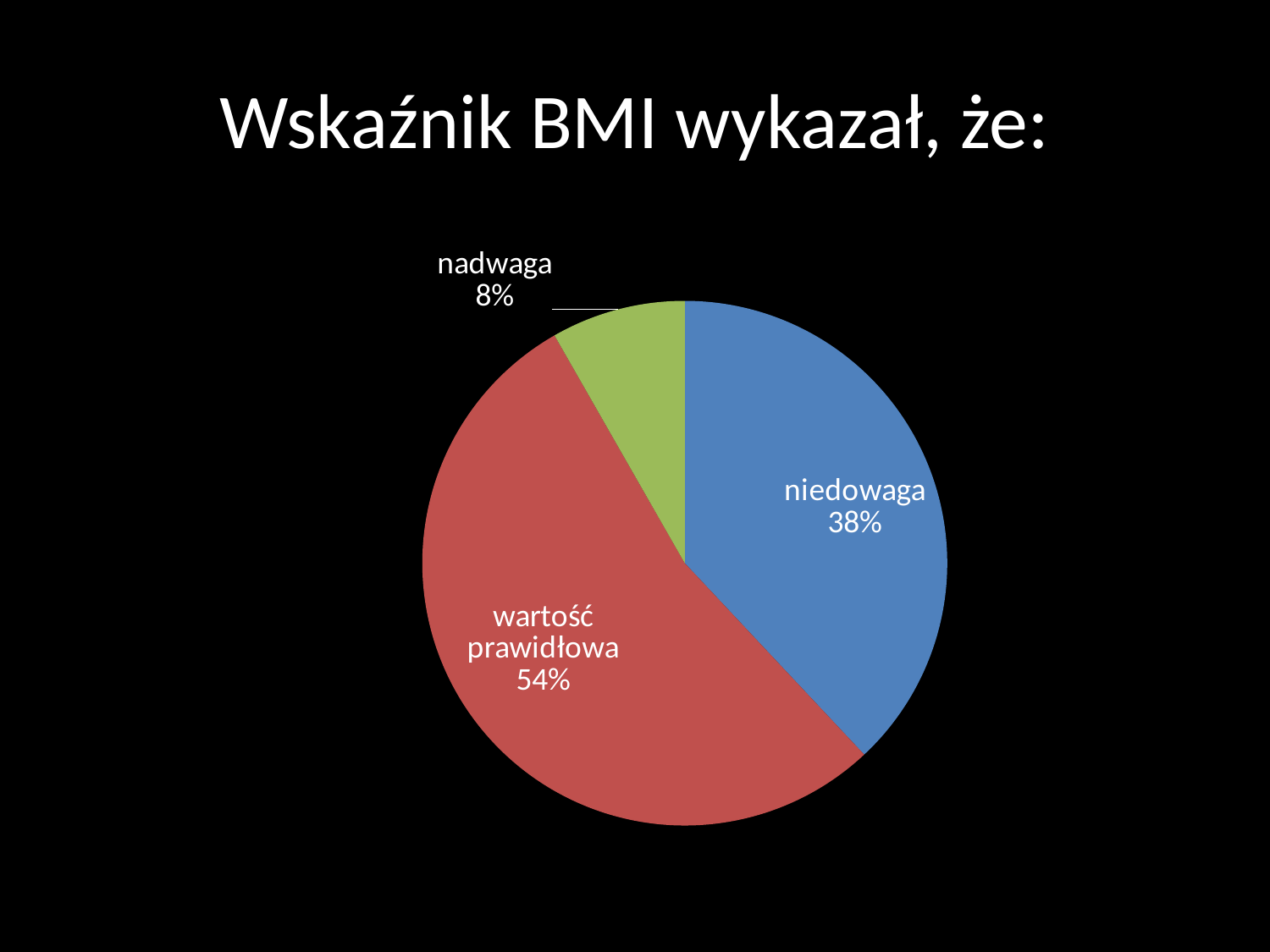
What colour is the "nadwaga" slice? green What is the difference in percentage points between "niedowaga" and "nadwaga"? 30 What is the difference in percentage points between "wartość prawidłowa" and "niedowaga"? 16 How many slices does the pie chart have? 3 What share of the pie does "nadwaga" have? 8% What share of the pie does "niedowaga" have? 38% Which category has the smallest slice of the pie? nadwaga Which is larger, the share for "niedowaga" or the share for "nadwaga"? niedowaga What kind of chart is shown on the slide? pie chart Which category has the largest slice of the pie? wartość prawidłowa What is the title of the slide above the chart? Wskaźnik BMI wykazał, że: What share of the pie does "wartość prawidłowa" have? 54%